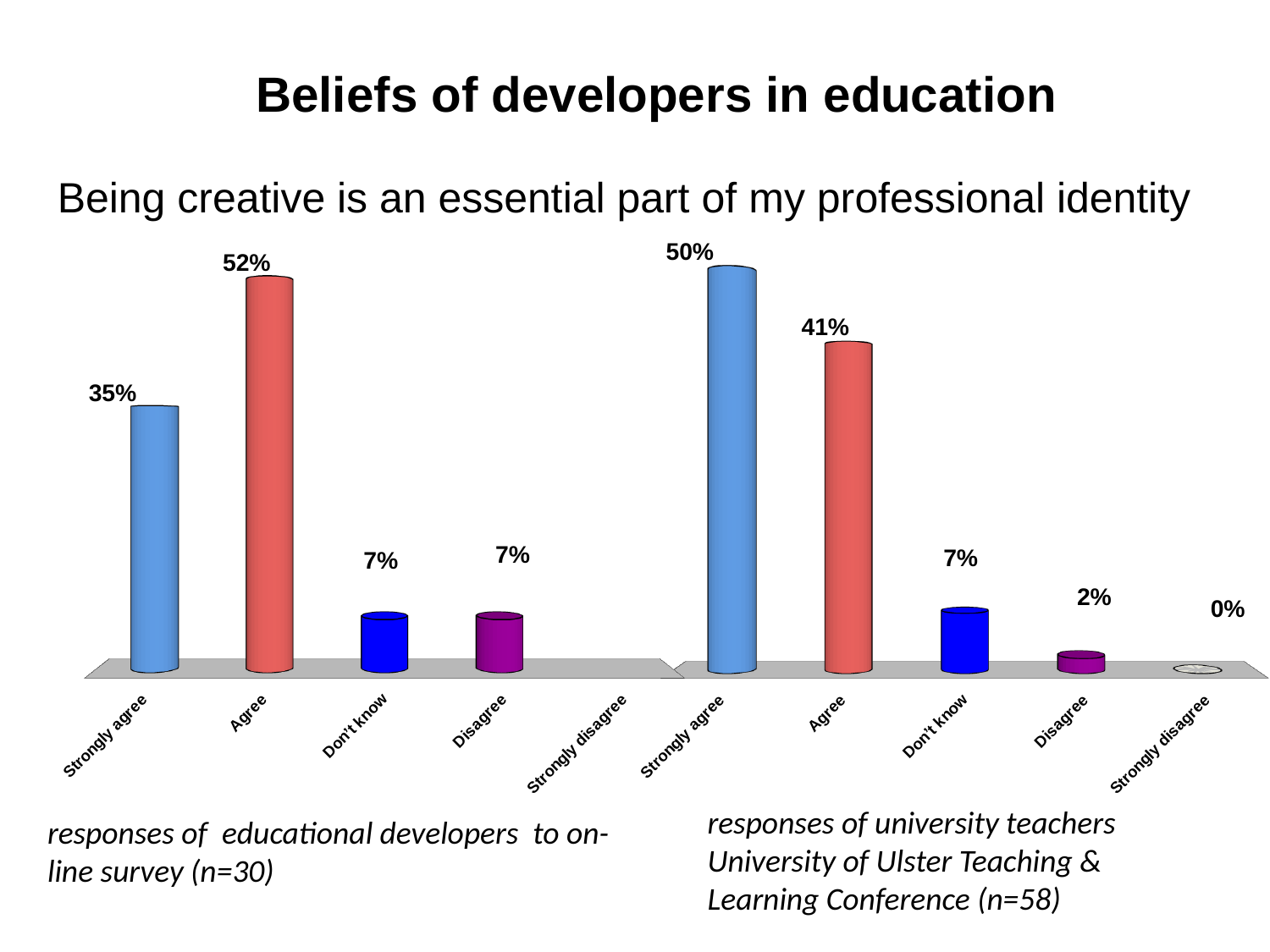
Which is larger: the Strongly agree value in the left chart (educational developers) or the Strongly agree value in the right chart (university teachers)? Right chart (university teachers), 50% In the right chart (university teachers), which response category has the lowest value? Strongly disagree In the left chart (educational developers), which response category has the highest value? Agree How many response categories are shown on the x axis of the right chart (university teachers)? 5 In the right chart (university teachers), what is the difference between the Strongly agree and Agree percentages? 9% In the left chart (educational developers), what percentage of respondents chose Agree? 52% In the right chart (university teachers), what percentage of respondents chose Disagree? 2% In the right chart (university teachers), what percentage of respondents chose Strongly agree? 50% What is the survey statement shown above the charts? Being creative is an essential part of my professional identity What type of chart is used on this slide? Bar chart In the left chart (educational developers), what is the difference between the Agree and Strongly agree percentages? 17% In the right chart (university teachers), which response category has the highest value? Strongly agree